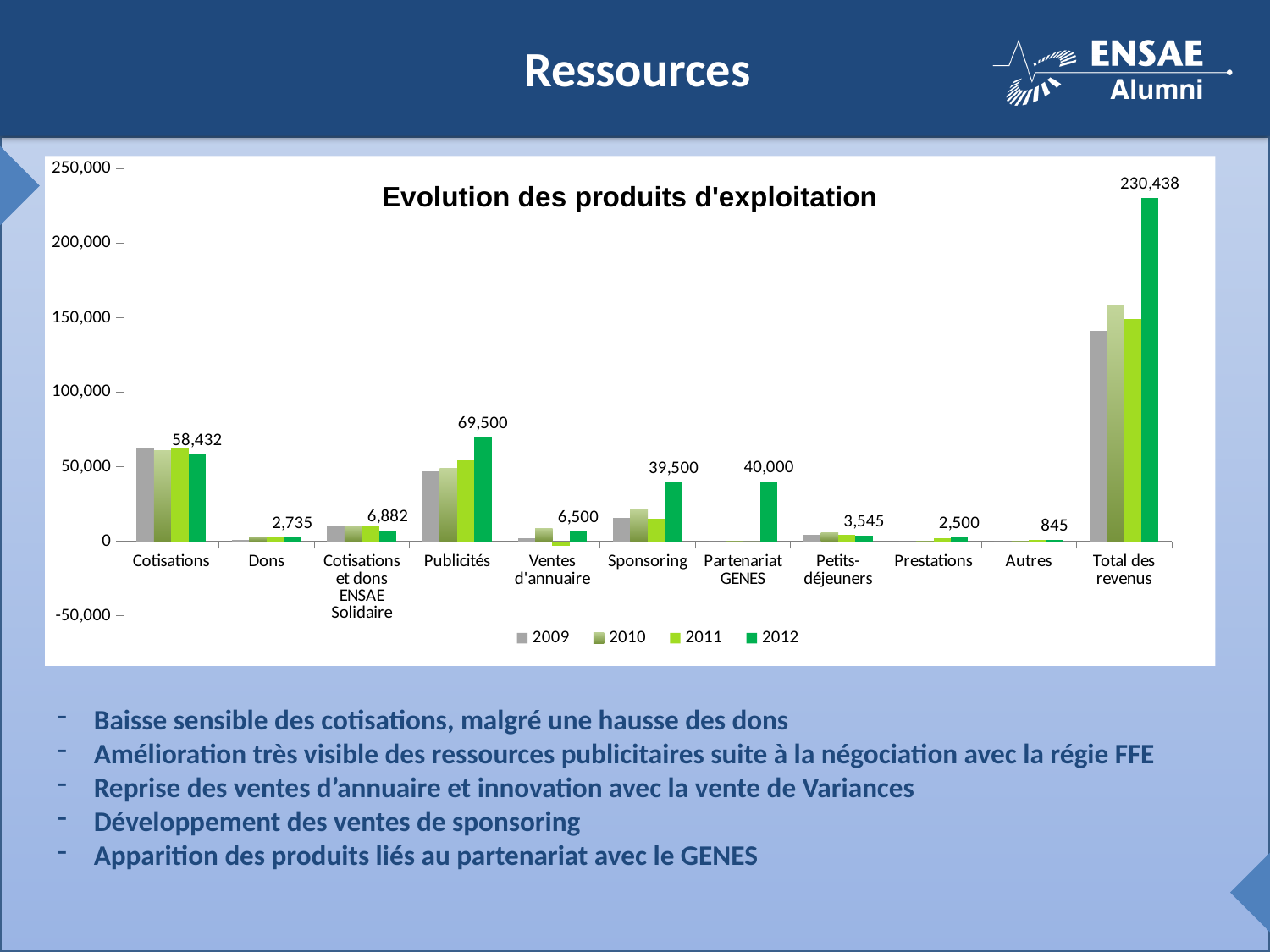
What type of chart is shown on the slide? bar chart What is the 2012 value for Cotisations? 58,432 What is the 2012 value for Partenariat GENES? 40,000 How many series does the chart legend list? 4 How many categories are shown on the x axis of the chart? 11 Is the 2009 value for Total des revenus greater or less than 100,000? greater What is the difference between the 2012 values for Publicités and Sponsoring? 30,000 What is the 2012 value for Publicités? 69,500 What is the title of the chart? Evolution des produits d'exploitation Which category has the lowest 2012 value? Autres Which is larger, the 2012 value for Sponsoring or the 2012 value for Partenariat GENES? Partenariat GENES What is the 2012 value for Total des revenus? 230,438